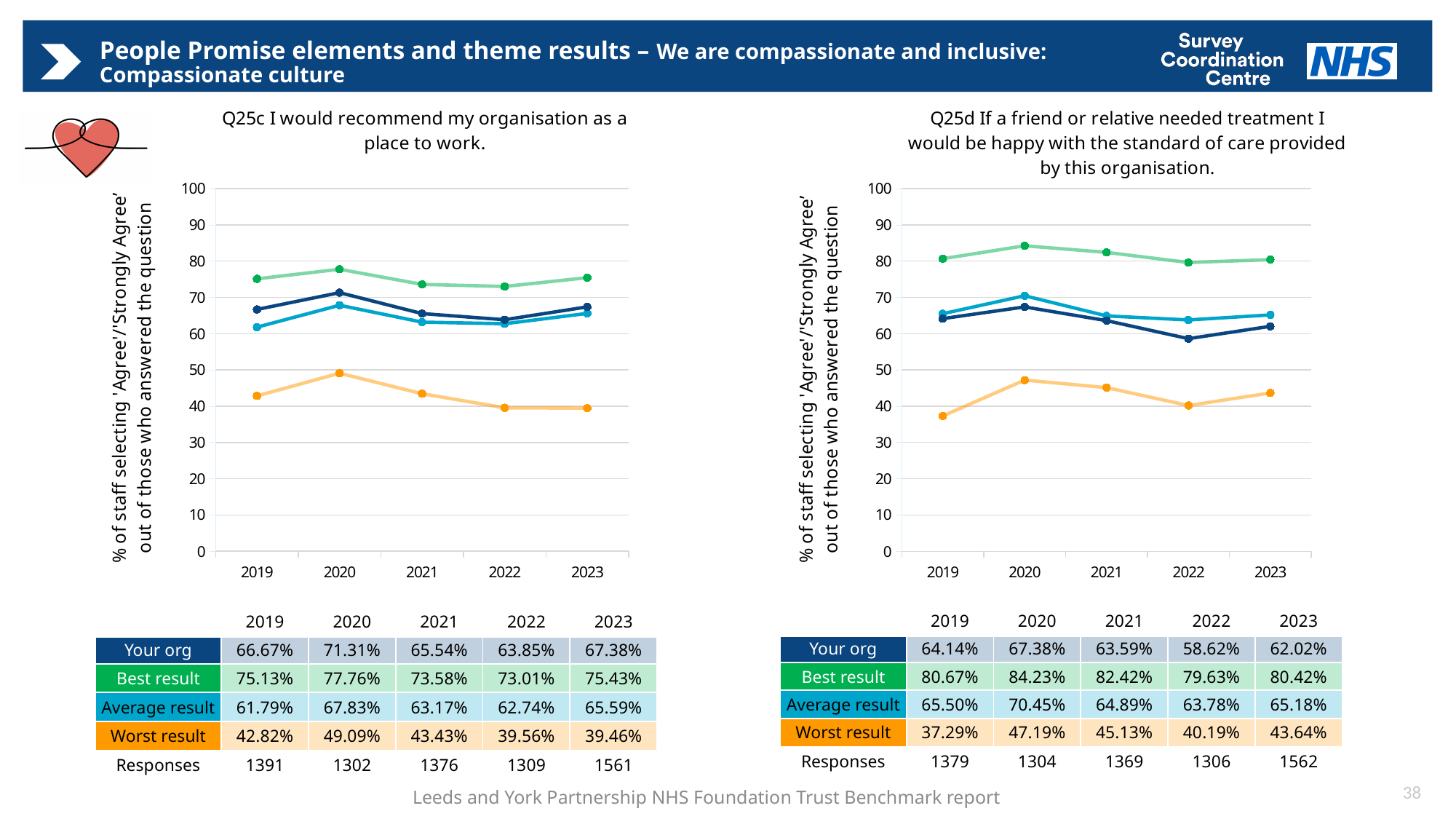
How many years are plotted on the x axis of the Q25d chart? 5 How many series are plotted in the Q25c chart? 4 In the Q25c chart, is the 'Worst result' value for 2020 greater or less than 40? greater In the Q25c chart, how many responses were recorded in 2023? 1561 In the Q25d chart, which year had the lowest 'Your org' value? 2022 In the Q25d chart, what was the 'Worst result' value in 2019? 37.29% In the Q25c chart, what is the difference between the 'Best result' and 'Your org' values in 2023? 8.05% What type of chart is used for Q25c? Line chart In the Q25d chart, which is larger in 2021: the 'Your org' value or the 'Average result' value? Average result In the Q25c chart, what was the 'Your org' value in 2020? 71.31% In the Q25c chart, which year had the highest 'Best result' value? 2020 In the Q25d chart, did the 'Your org' value rise or fall from 2021 to 2022? Fall